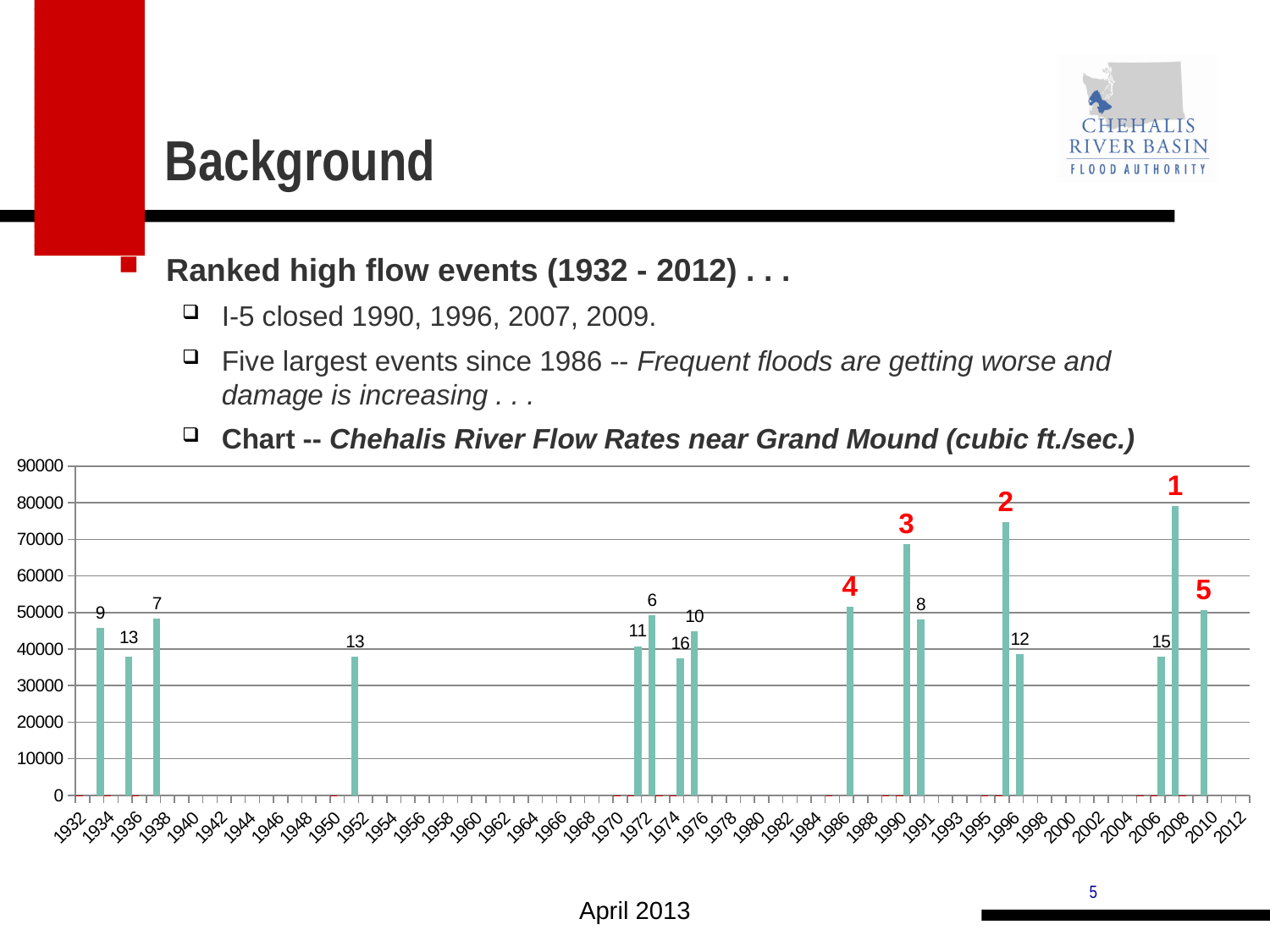
Is the value of the bar labelled 5 greater or less than 40000? greater Is the value of the bar labelled 1 greater or less than 70000? greater Which is larger, the bar labelled 1 or the bar labelled 2? the bar labelled 1 What is the highest value shown on the chart's vertical axis? 90000 Is the value of the bar labelled 3 greater or less than 60000? greater What is the title of the chart as given in the bullet text? Chehalis River Flow Rates near Grand Mound (cubic ft./sec.) What kind of chart is shown on the slide? bar chart Which rank label is shown above the tallest bar in the chart? 1 Which is larger, the bar labelled 3 or the bar labelled 4? the bar labelled 3